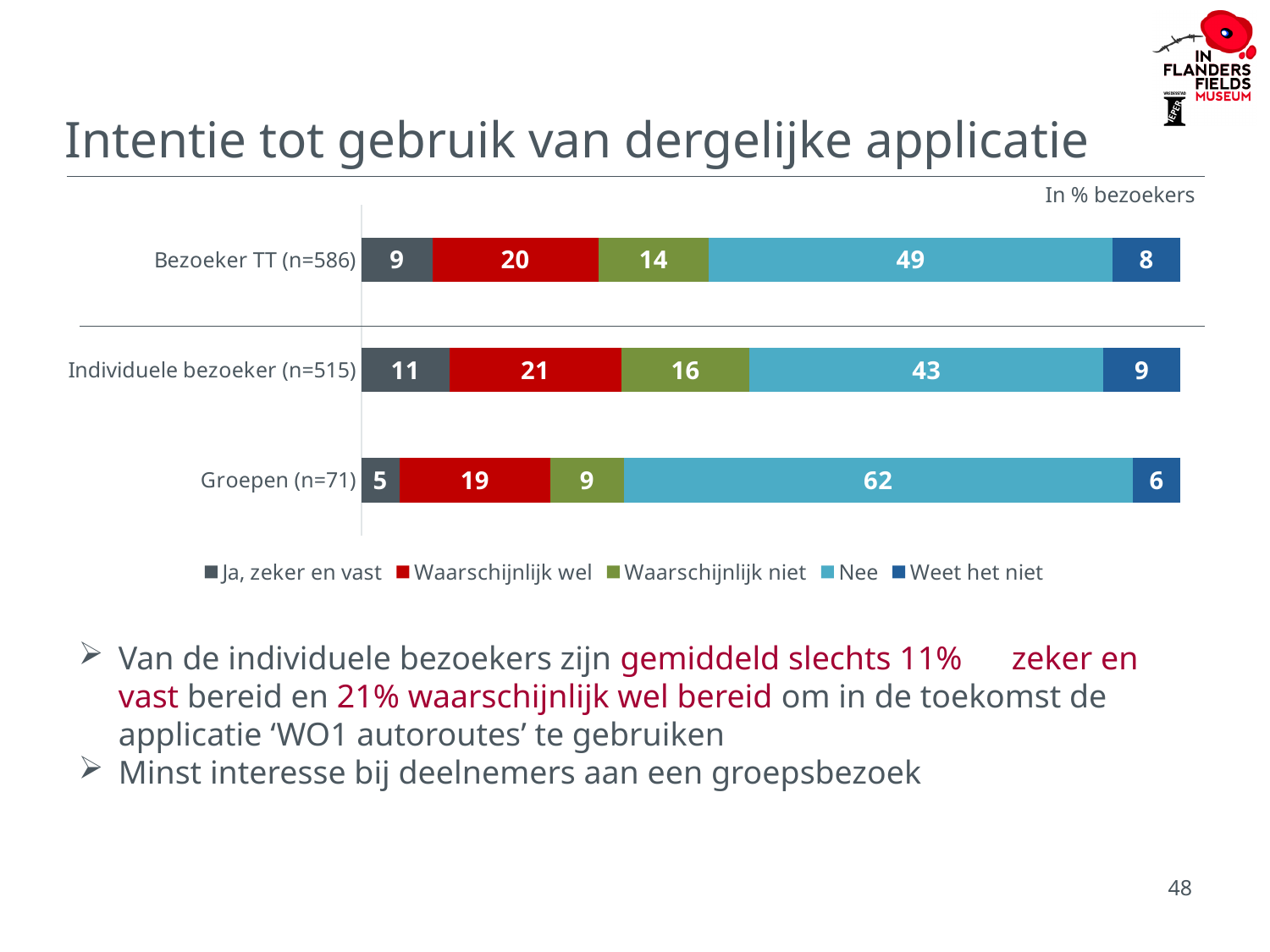
What is the total of the stacked bar for Bezoeker TT (n=586)? 100 Which category has the highest value for "Nee"? Groepen (n=71) Which is larger: the "Waarschijnlijk niet" value for Individuele bezoeker (n=515) or for Groepen (n=71)? Individuele bezoeker (n=515) What kind of chart is shown on the slide? Stacked bar chart How many series does the legend list? 5 What is the value for "Ja, zeker en vast" for Individuele bezoeker (n=515)? 11 Which category has the lowest value for "Ja, zeker en vast"? Groepen (n=71) What is the value for "Nee" for Groepen (n=71)? 62 What is the title of the chart on the slide? Intentie tot gebruik van dergelijke applicatie What is the value for "Waarschijnlijk wel" for Bezoeker TT (n=586)? 20 What is the difference between the "Nee" values for Groepen (n=71) and Individuele bezoeker (n=515)? 19 How many categories are shown on the chart? 3